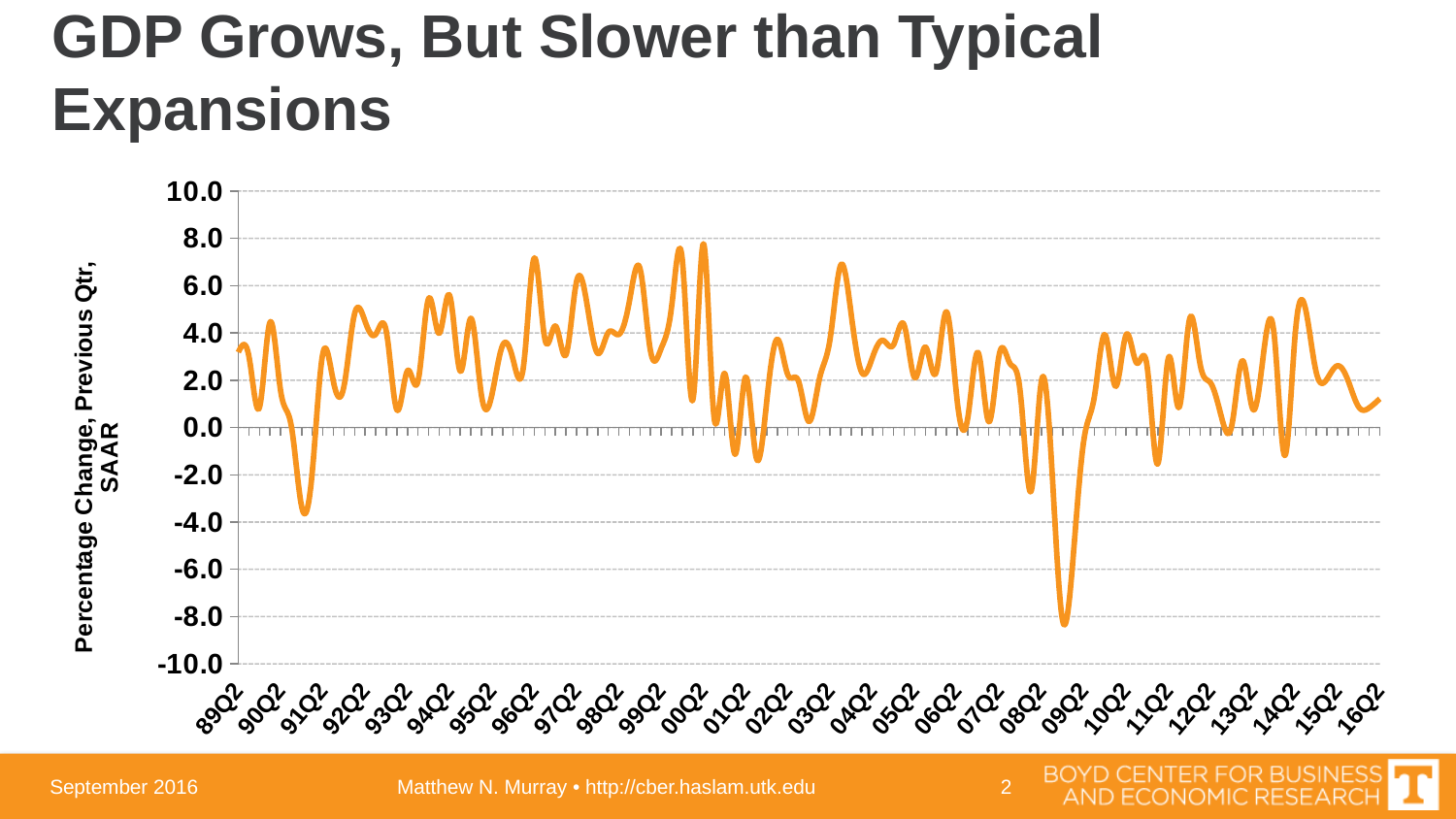
Is the lowest point on the line greater or less than -6.0? less How many quarter labels are shown along the horizontal axis? 28 What is the label on the vertical axis of the chart? Percentage Change, Previous Qtr, SAAR How many lines are plotted on the chart? 1 What is the first quarter labeled on the horizontal axis? 89Q2 Which is larger, the value at 00Q2 or the value at 16Q2? 00Q2 Is the value at 16Q2, the last point on the line, greater or less than 2.0? less Is the highest point on the line greater or less than 6.0? greater What kind of chart is shown on the slide? line chart What is the highest value marked on the vertical axis? 10.0 Which is lower, the trough near 91Q2 or the trough near 09Q2? 09Q2